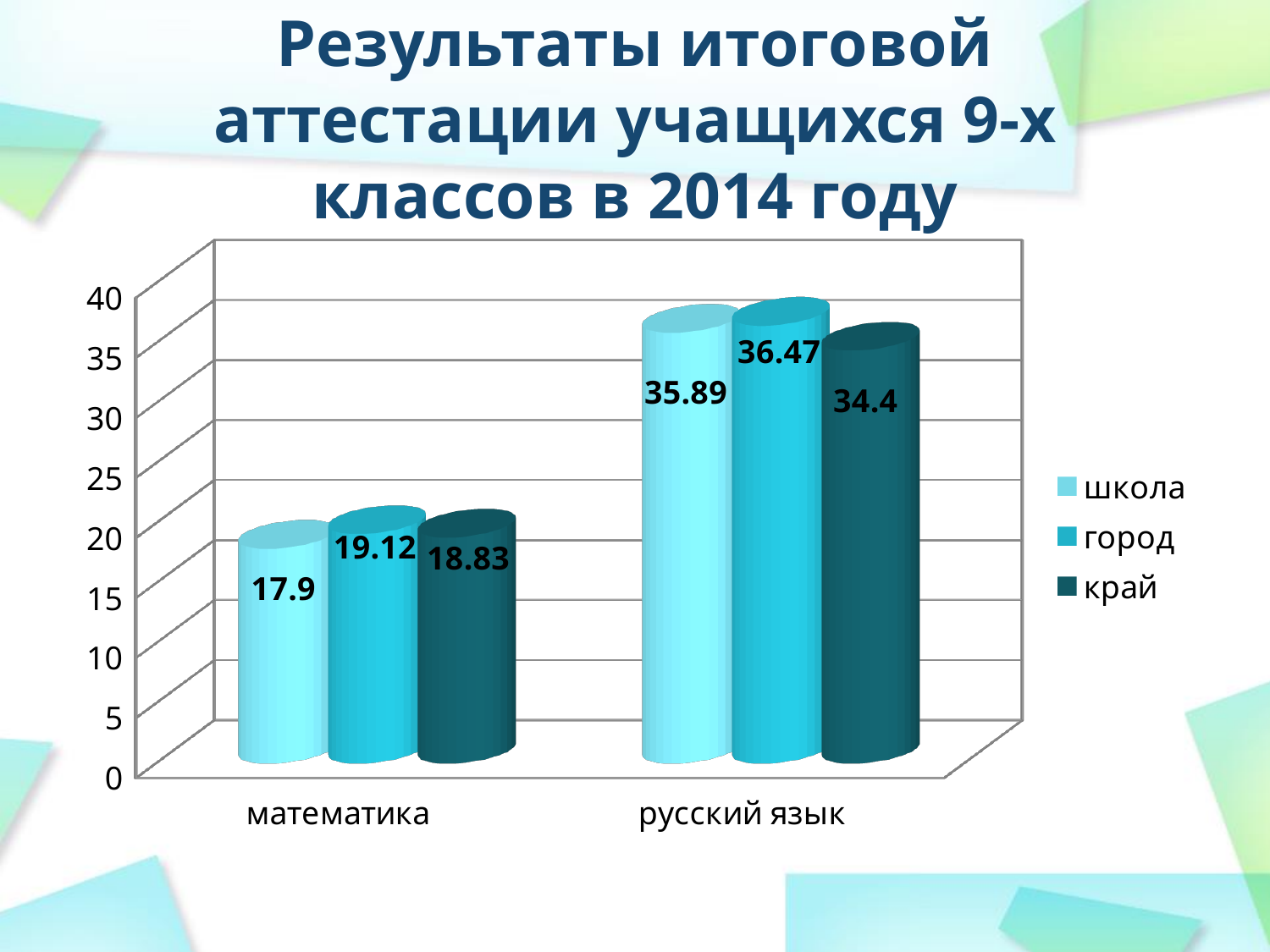
Which series has the highest value in русский язык? город What is the value for школа in математика? 17.9 Which is larger: школа in русский язык or край in русский язык? школа in русский язык How many categories are shown on the x axis? 2 What is the value for город in русский язык? 36.47 What kind of chart is shown on the slide? bar chart What is the value for край in русский язык? 34.4 Which series has the lowest value in математика? школа What is the difference between город and край in русский язык? 2.07 What is the difference between город and школа in математика? 1.22 How many series does the legend list? 3 What is the value for край in математика? 18.83